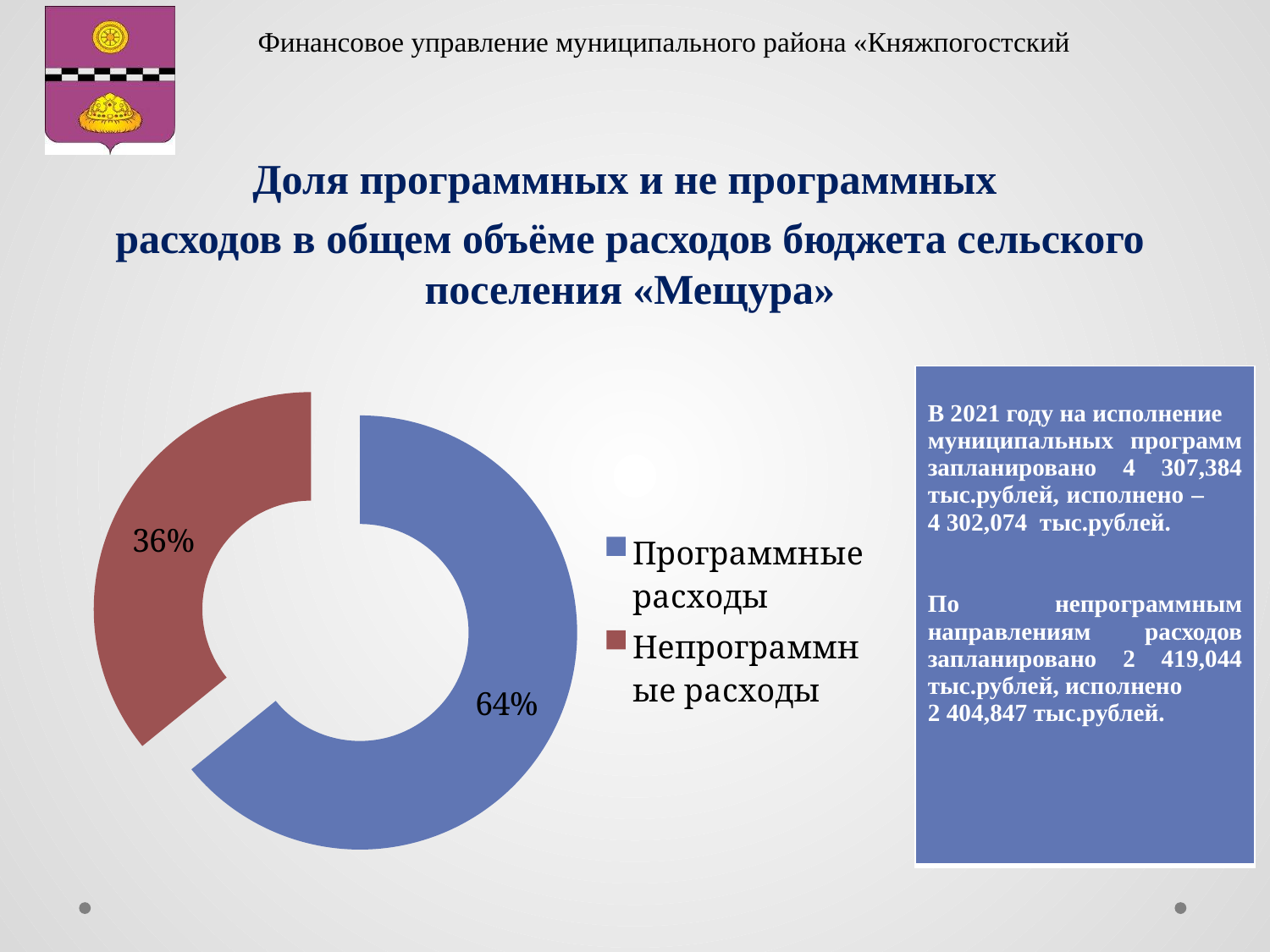
Which category has the largest share in the chart? Программные расходы What kind of chart is shown on the slide? Doughnut (pie) chart Which is larger: the share of "Программные расходы" or the share of "Непрограммные расходы"? Программные расходы Which category has the smallest share in the chart? Непрограммные расходы How many entries does the chart legend list? 2 What is the difference in percentage points between the shares of "Программные расходы" and "Непрограммные расходы"? 28 What colour is the "Непрограммные расходы" segment in the chart? Red What colour is the "Программные расходы" segment in the chart? Blue How many categories does the chart show? 2 What share of the chart is labelled "Непрограммные расходы"? 36% What share of the chart is labelled "Программные расходы"? 64%